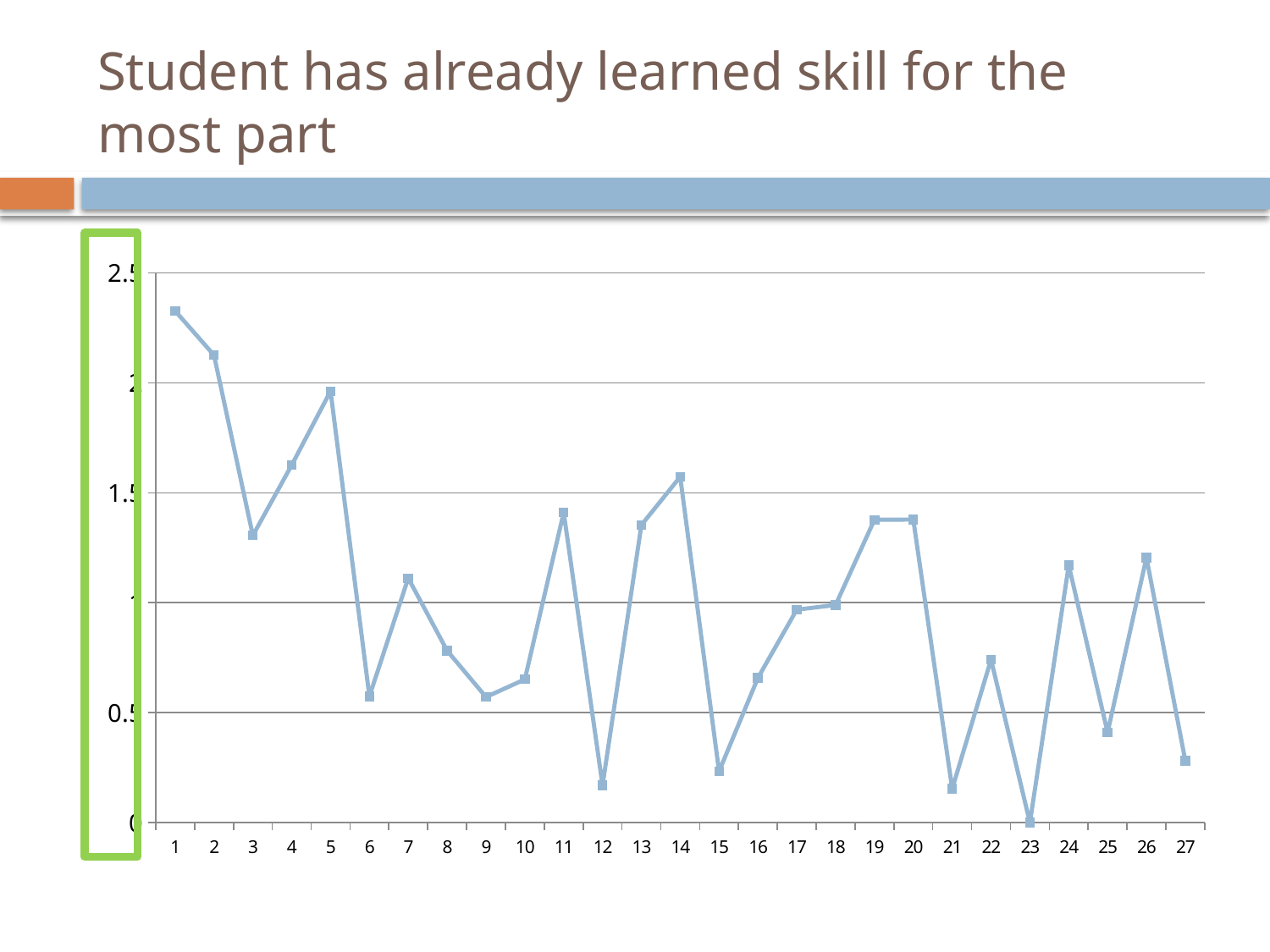
Is the value at point 14 greater or less than 1.5? greater Is the value at point 1 greater or less than 2? greater Which x-axis point has the highest value? 1 Is the value at point 21 greater or less than 0.5? less Overall, do the values rise or fall from point 1 to point 27? fall What kind of chart is shown on the slide? line chart Which is larger, the value at point 5 or the value at point 6? point 5 What is the value at point 23? 0 How many points are plotted along the x axis? 27 Which x-axis point has the lowest value? 23 How many lines are plotted on the chart? 1